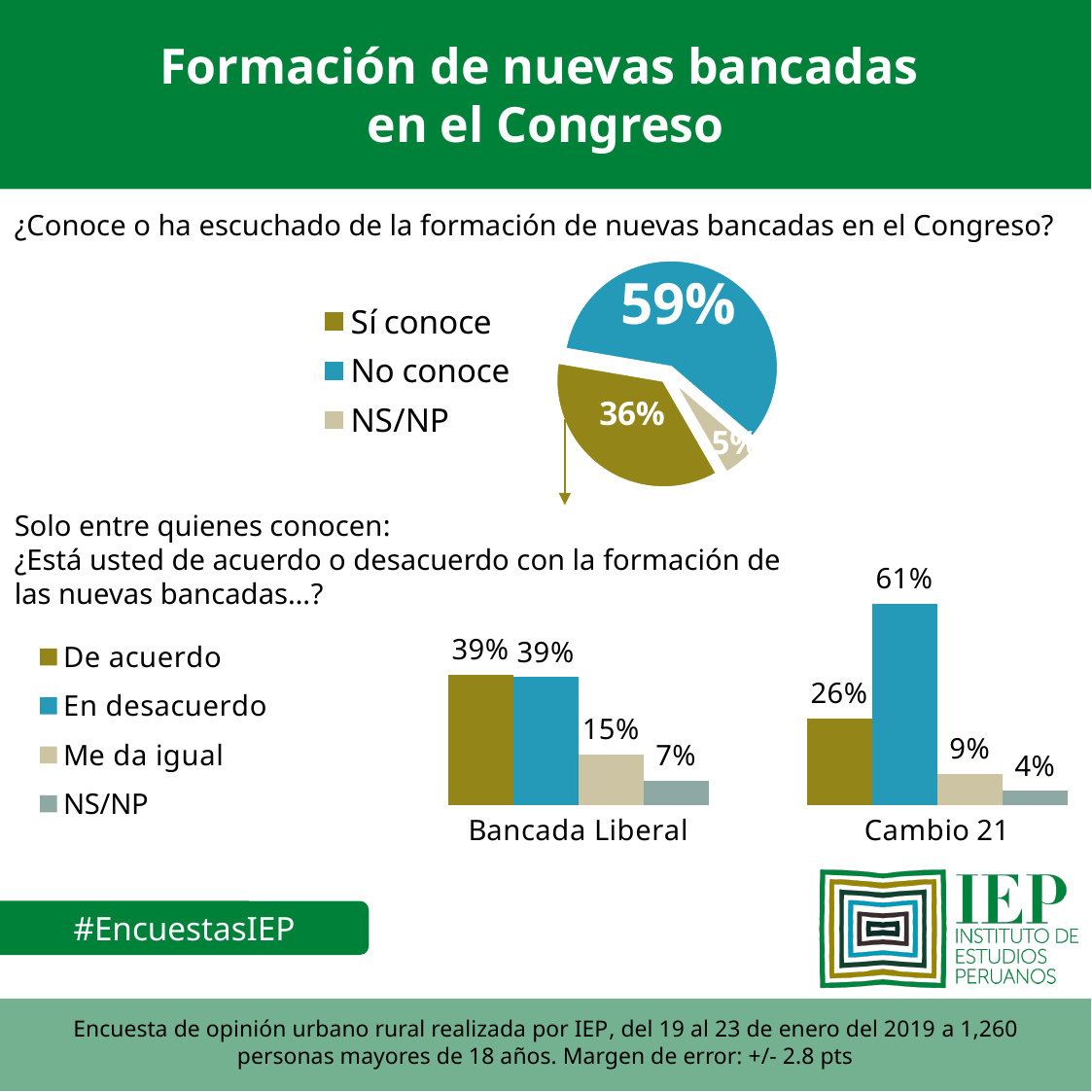
In the bar chart, which is larger for Bancada Liberal: "Me da igual" or "NS/NP"? Me da igual What kind of chart is the lower chart on the slide? Bar chart In the pie chart, how many categories does the legend list? 3 In the pie chart, which category has the smallest slice? NS/NP In the pie chart, what share of respondents answered "Sí conoce"? 36% In the bar chart, what is the value for "En desacuerdo" for Cambio 21? 61% In the bar chart, how many series does the legend list? 4 In the bar chart, what is the difference between "En desacuerdo" and "De acuerdo" for Cambio 21? 35% In the bar chart, what is the value for "De acuerdo" for Cambio 21? 26% In the bar chart, what is the value for "Me da igual" for Bancada Liberal? 15% In the pie chart, what share of respondents answered "No conoce"? 59% What kind of chart is the upper chart on the slide? Pie chart